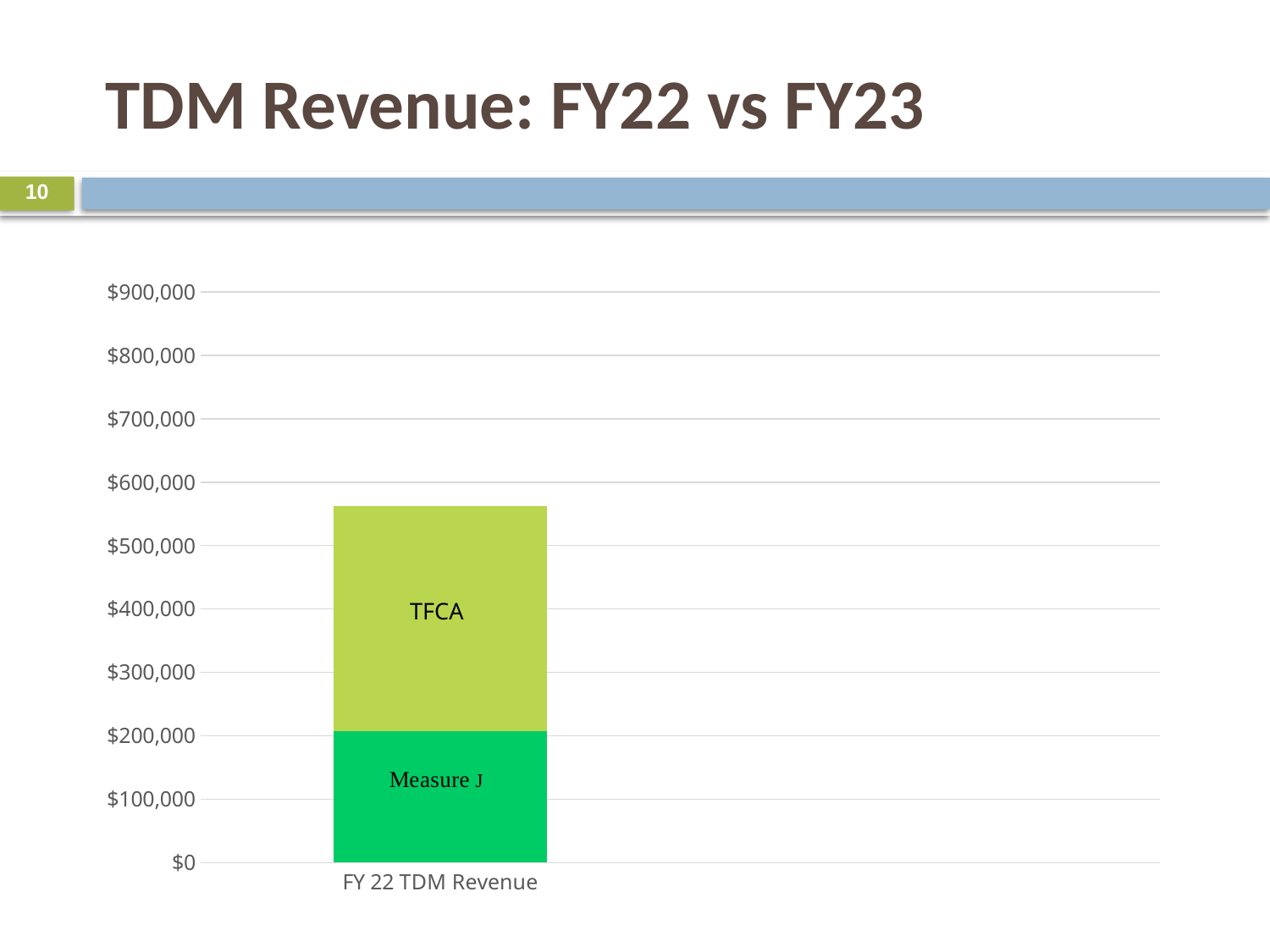
Which segment of the FY 22 TDM Revenue bar is larger, TFCA or Measure J? TFCA What is the label of the single category on the x axis? FY 22 TDM Revenue What is the title of the slide containing the chart? TDM Revenue: FY22 vs FY23 Is the total height of the FY 22 TDM Revenue bar greater or less than $500,000? greater How many categories are plotted on the x axis of the chart? 1 Which segment is at the bottom of the stacked bar, TFCA or Measure J? Measure J Is the TFCA segment of the FY 22 TDM Revenue bar greater or less than $300,000? greater What kind of chart is shown on the slide? bar chart Is the total height of the FY 22 TDM Revenue bar greater or less than $600,000? less